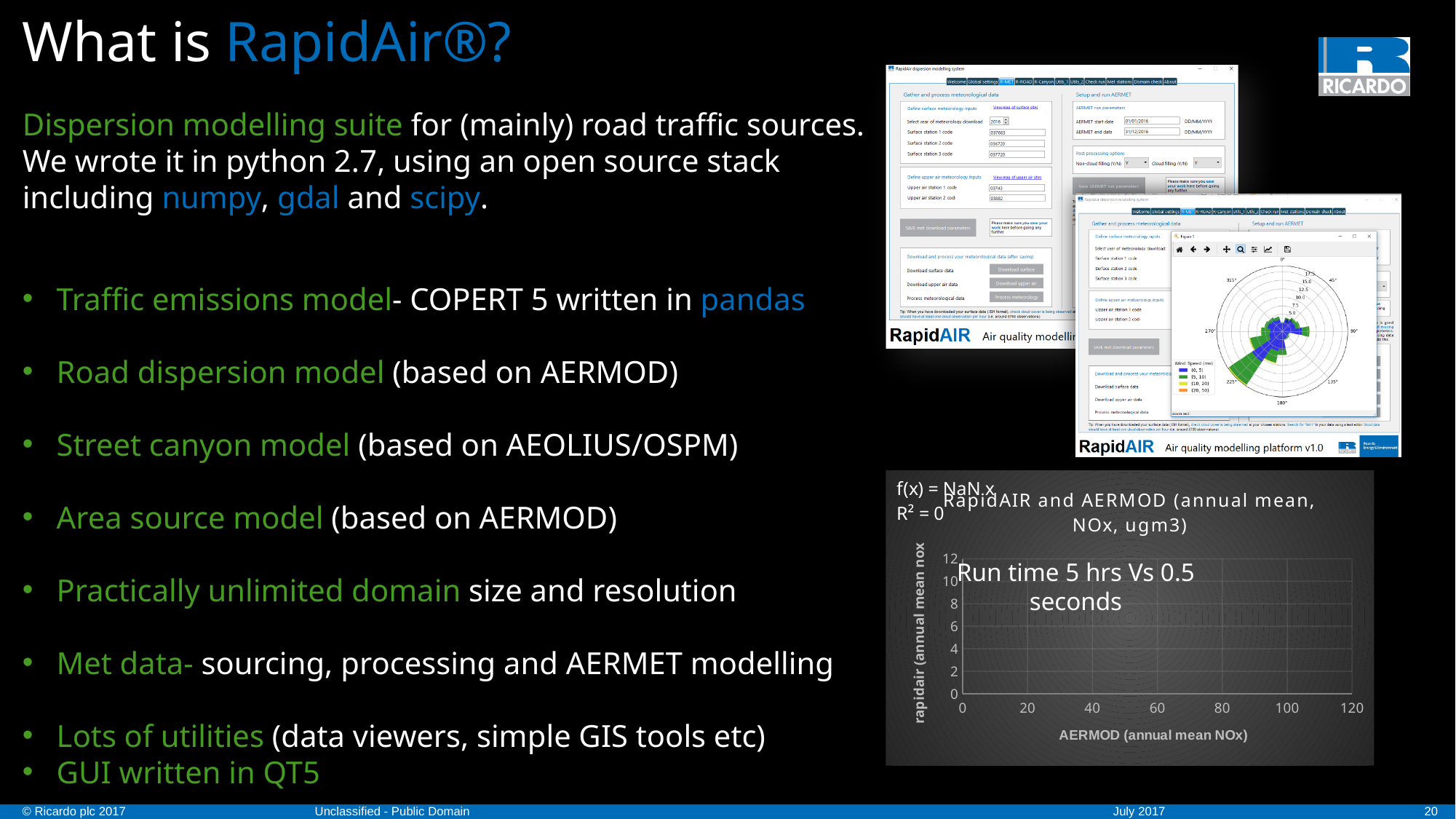
What kind of chart is the 'RapidAIR and AERMOD (annual mean, NOx, ugm3)' chart? scatter chart In the 'RapidAIR and AERMOD (annual mean, NOx, ugm3)' chart, what is the label of the x axis? AERMOD (annual mean NOx) What is the title of the chart at the bottom right of the slide? RapidAIR and AERMOD (annual mean, NOx, ugm3) In the 'RapidAIR and AERMOD (annual mean, NOx, ugm3)' chart, what is the highest tick value shown on the x axis? 120 What R² value is printed on the 'RapidAIR and AERMOD (annual mean, NOx, ugm3)' chart? R² = 0 In the 'RapidAIR and AERMOD (annual mean, NOx, ugm3)' chart, what is the highest tick value shown on the y axis? 12